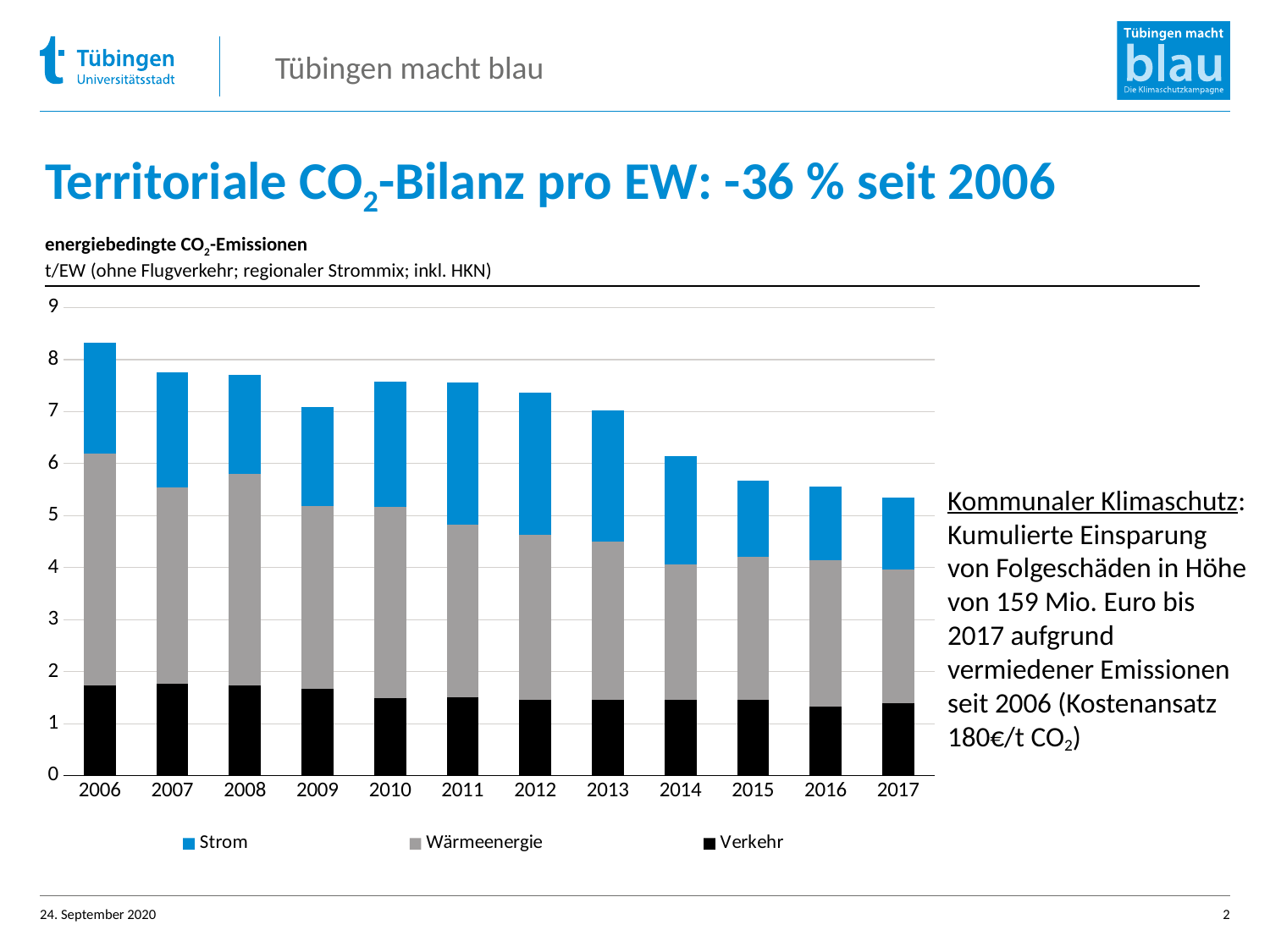
Which year has the highest total bar in the chart? 2006 Which total bar is larger, 2006 or 2017? 2006 Which series are listed in the chart legend? Strom, Wärmeenergie, Verkehr Is the total bar for 2017 greater or less than 6? less Is the total bar for 2015 greater or less than 6? less Is the total bar for 2006 greater or less than 8? greater What kind of chart is shown on the slide? Stacked bar chart Do the total bars generally rise or fall from 2006 to 2017? fall How many years are shown on the x axis of the chart? 12 How many series does the chart legend list? 3 What unit is given for the values in the chart? t/EW